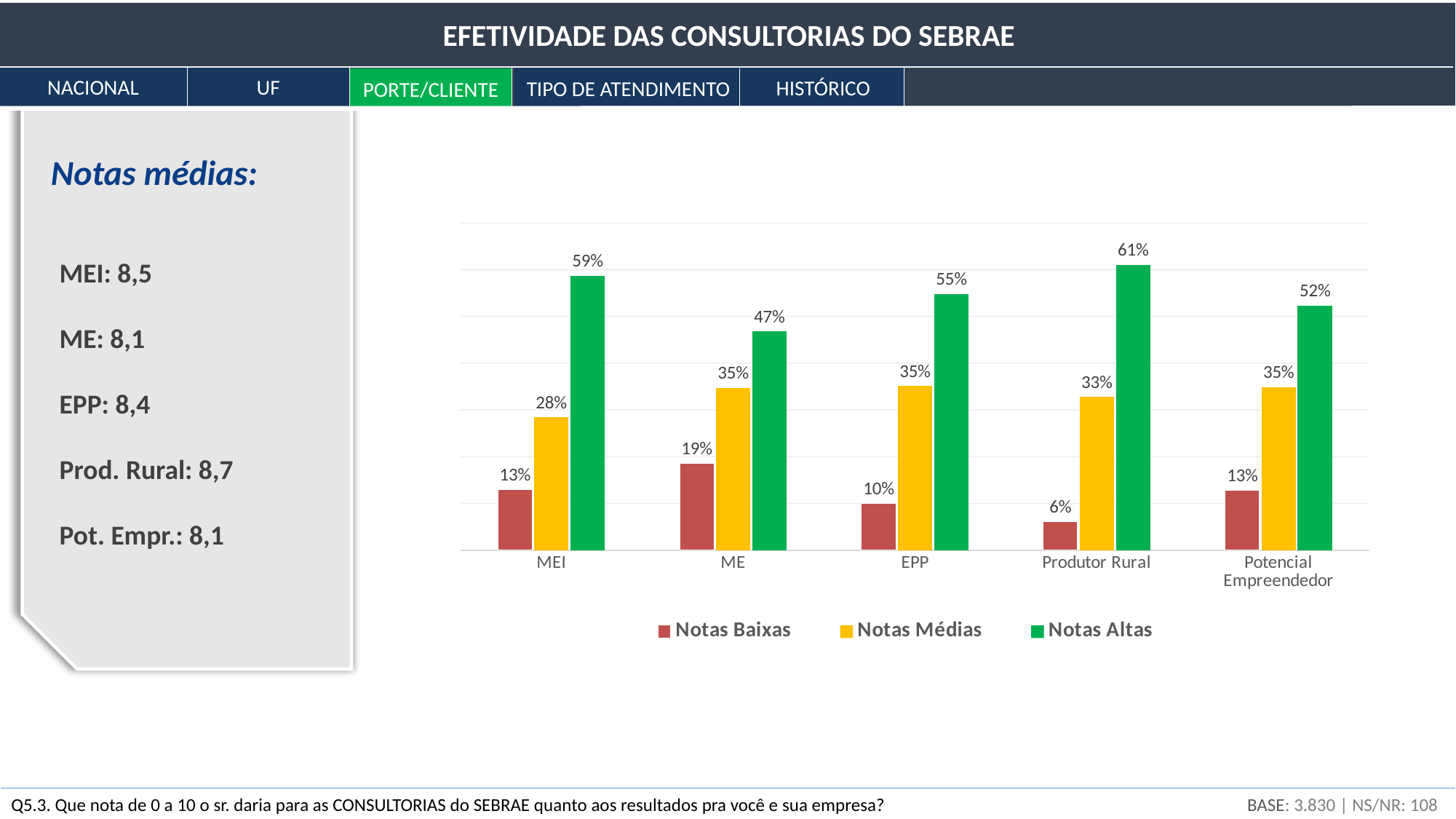
How many series does the legend list? 3 Which category has the lowest Notas Altas value? ME What is the value of Notas Baixas for Produtor Rural? 6% What is the value of Notas Altas for MEI? 59% How many categories are shown on the x axis? 5 What is the difference between Notas Altas for Produtor Rural and Notas Altas for ME? 14% Which colour represents Notas Altas in the legend? Green Which category has the highest Notas Altas value? Produtor Rural Which category has the lowest Notas Baixas value? Produtor Rural Which is larger: Notas Baixas for ME or Notas Baixas for EPP? Notas Baixas for ME What kind of chart is shown on the slide? Bar chart What is the value of Notas Médias for ME? 35%